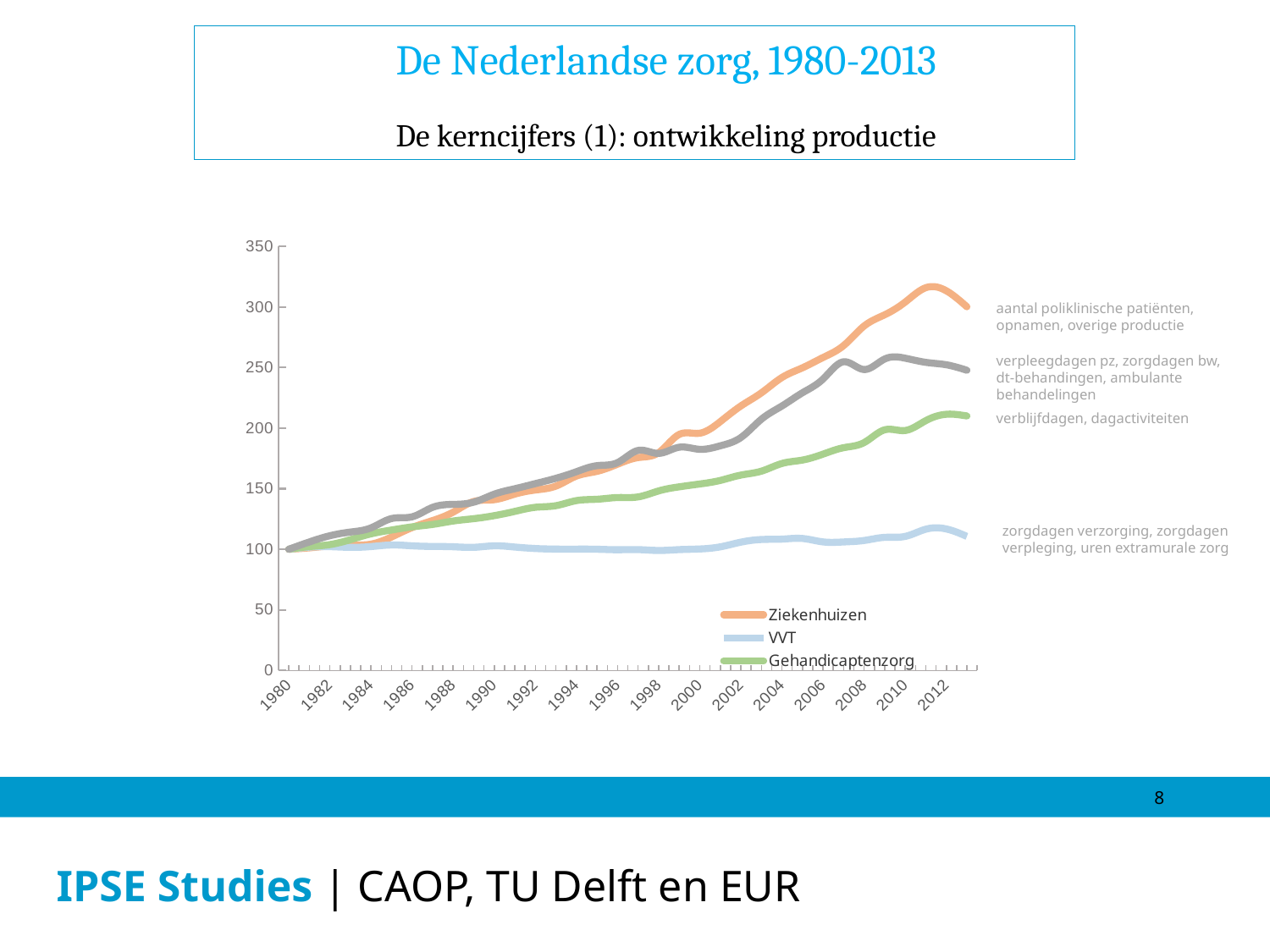
Which is larger in 2006, the value for Gehandicaptenzorg or the value for VVT? Gehandicaptenzorg What is the value of the Ziekenhuizen series in 1980? 100 Does the Ziekenhuizen series generally rise or fall between 1980 and 2010? rise Is the value for Ziekenhuizen in 2000 greater or less than 150? greater How many series does the chart legend list? 3 What kind of chart is shown on the slide? line chart Is the value for Gehandicaptenzorg in 2012 greater or less than 200? greater Which series has the lowest value in 2012? VVT Which series has the highest value in 2012? Ziekenhuizen Is the value for VVT in 2012 greater or less than 150? less What colour is the Ziekenhuizen line in the chart? orange